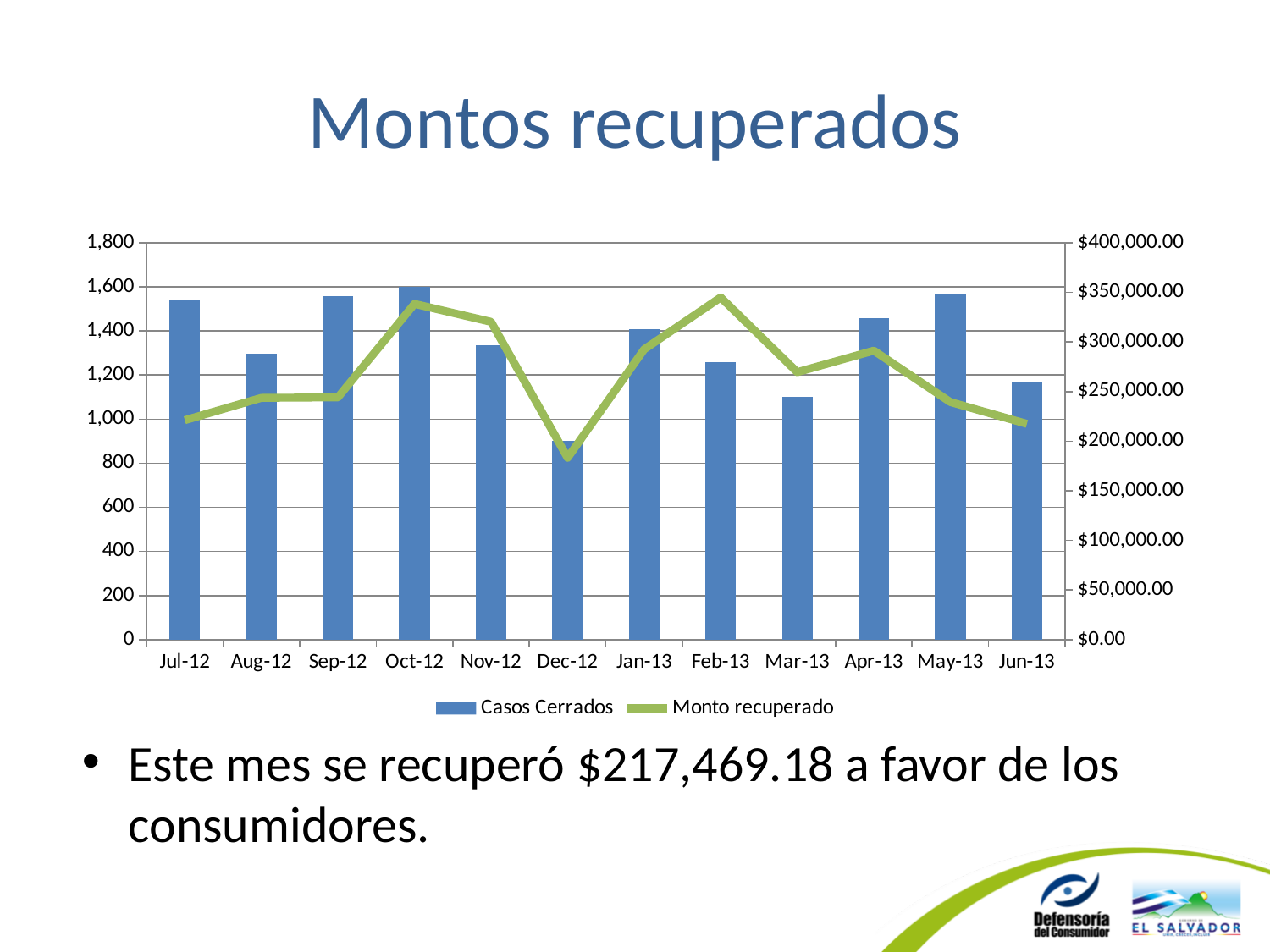
How many months are shown on the x axis of the chart? 12 Which month has the lowest value for Casos Cerrados? Dec-12 Which month has more Casos Cerrados, Jul-12 or Aug-12? Jul-12 How many series does the chart legend list? 2 Which month has the lowest value for Monto recuperado? Dec-12 Does the Monto recuperado line rise or fall from Oct-12 to Dec-12? fall What is the title of the chart? Montos recuperados Is the value of Casos Cerrados for Dec-12 greater or less than 1,000? less Is the value of Casos Cerrados for Jul-12 greater or less than 1,400? greater Which series is drawn as a line in the chart? Monto recuperado What kind of chart is shown on the slide? A combined bar and line chart Is the value of Monto recuperado for Oct-12 greater or less than $300,000.00? greater